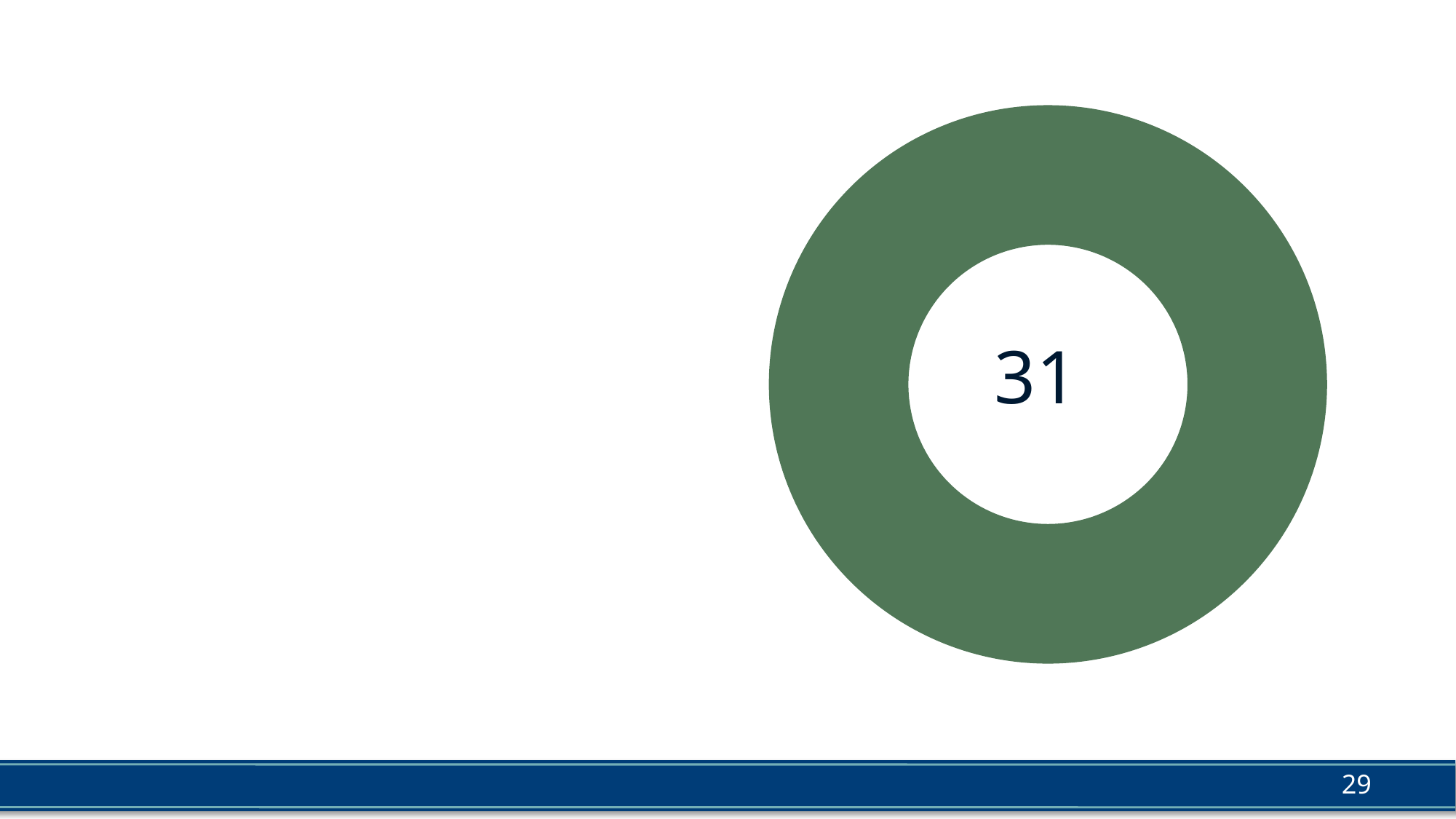
What kind of chart is shown on the slide? doughnut chart What number is printed in the centre of the doughnut chart? 31 How many slices does the doughnut chart show? 1 What colour is the ring of the doughnut chart? green What share of the doughnut ring does the single green slice occupy? 100%